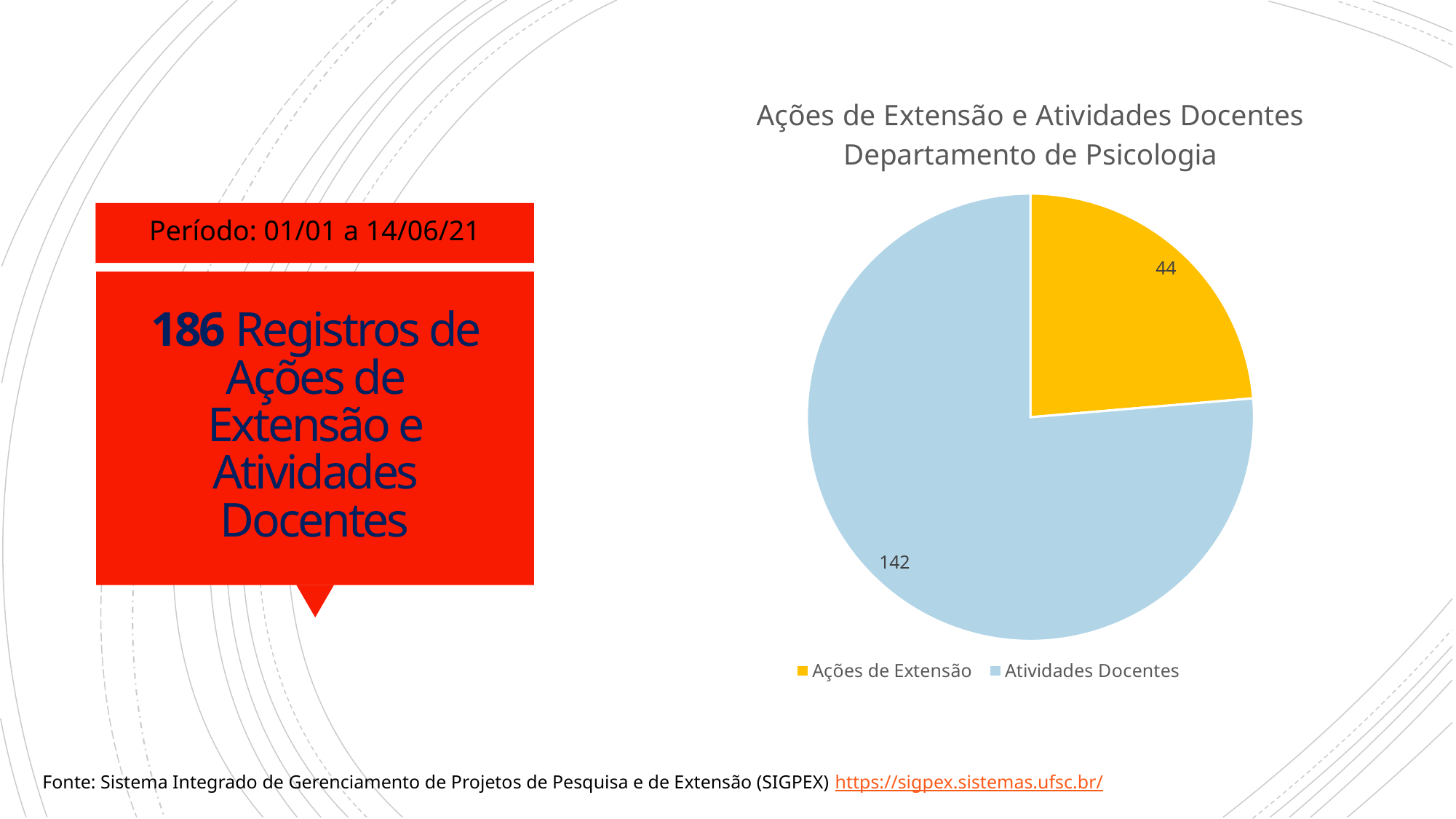
What kind of chart is shown on the slide? pie chart What is the total of the two slices in the pie chart? 186 What is the value for Ações de Extensão in the pie chart? 44 How many entries does the legend of the pie chart list? 2 Which slice of the pie chart is the smallest? Ações de Extensão What is the value for Atividades Docentes in the pie chart? 142 Which is larger, Ações de Extensão or Atividades Docentes? Atividades Docentes What is the difference between the values for Atividades Docentes and Ações de Extensão? 98 Which slice of the pie chart is the largest? Atividades Docentes How many slices does the pie chart have? 2 What share of the pie does Ações de Extensão represent, to the nearest whole percent? 24% What is the title of the pie chart? Ações de Extensão e Atividades Docentes Departamento de Psicologia